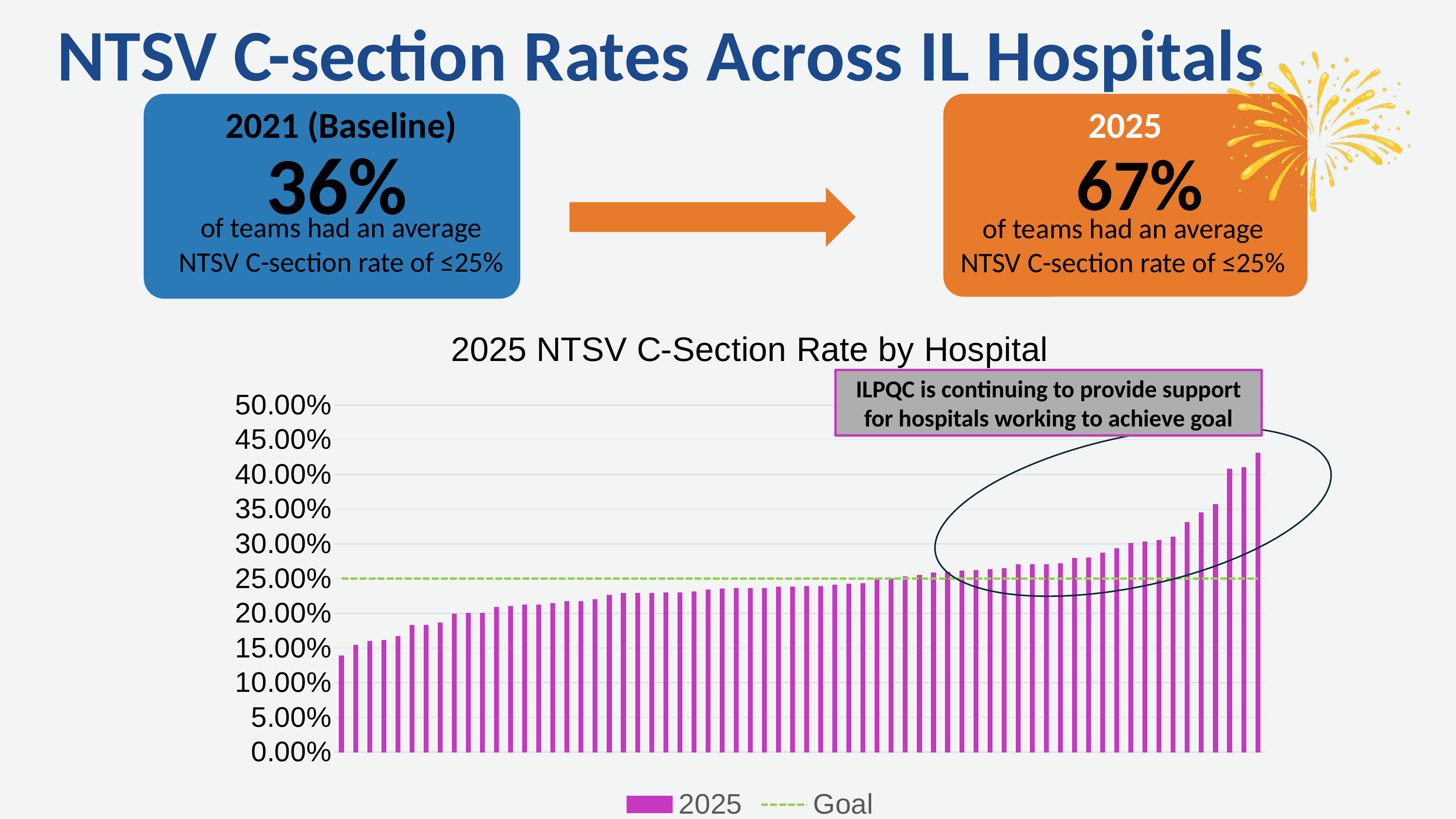
Do the bar values rise or fall from left to right along the x axis? rise Is the value of the shortest bar (leftmost) greater or less than 15.00%? less Which bar is the highest: the leftmost bar or the rightmost bar? the rightmost bar Is the value of the tallest bar greater or less than 45.00%? less Is the value of the leftmost bar greater or less than 10.00%? greater What is the highest value shown on the y axis of the chart? 50.00% How many entries does the legend of the chart list? 2 What are the two entries in the chart's legend? 2025 and Goal What is the title of the chart on the slide? 2025 NTSV C-Section Rate by Hospital What kind of chart is the "2025 NTSV C-Section Rate by Hospital" chart? bar chart At what value on the y axis is the dashed Goal line drawn? 25.00%